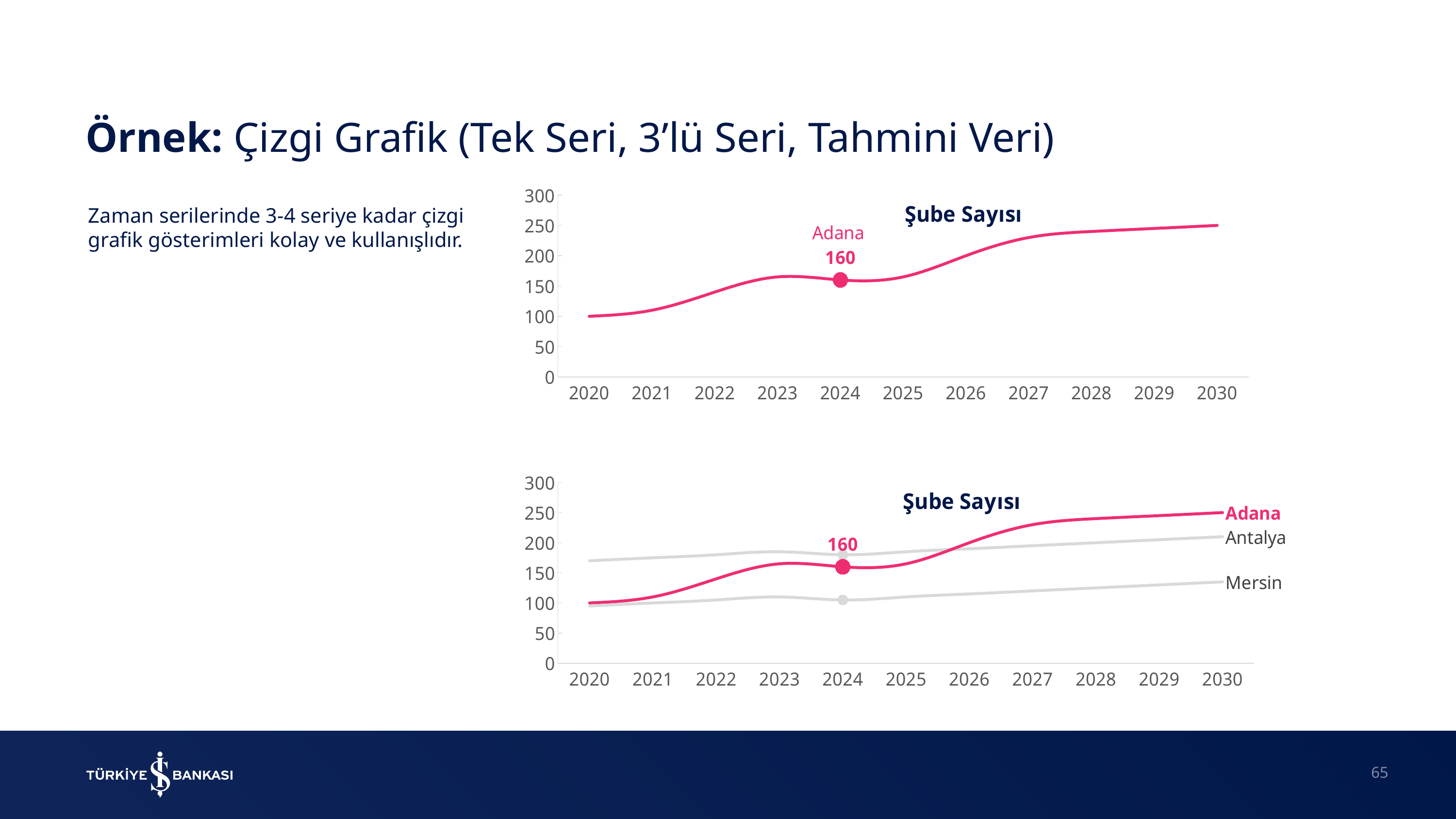
In the top chart, is the value for Adana in 2030 greater or less than 200? greater In the bottom chart, is the value for Antalya in 2020 greater or less than 150? greater In the top chart, is the value for Adana in 2020 greater or less than 150? less In the bottom chart, what is the labelled value for Adana in 2024? 160 In the top chart, what is the labelled value for Adana in 2024? 160 What kind of chart is the top chart? Line chart How many series are plotted in the bottom chart? 3 In the bottom chart, which is larger in 2020: Adana or Antalya? Antalya How many years are shown on the x axis of the bottom chart? 11 In the bottom chart, which series has the highest value in 2030? Adana In the bottom chart, which series has the lowest value in 2030? Mersin